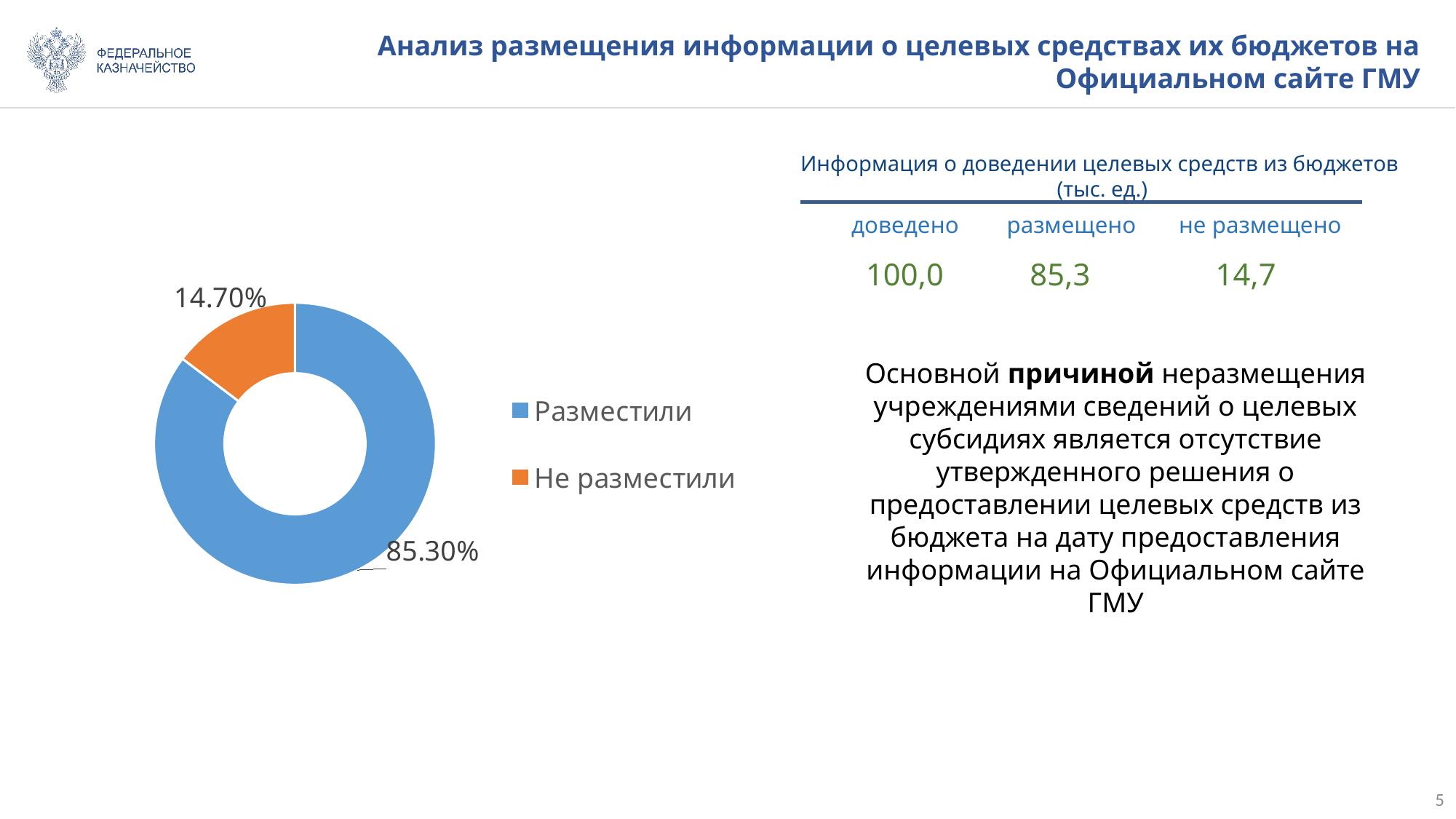
What is the share of the "Не разместили" slice in the doughnut chart? 14.70% Which slice of the doughnut chart is the smallest? Не разместили What share of the doughnut chart is labelled "Не разместили"? 14.70% What kind of chart is shown on the slide? Doughnut (pie) chart How many slices does the doughnut chart have? 2 Which slice of the doughnut chart is the largest? Разместили How many entries does the chart legend list? 2 By how many percentage points does the "Разместили" slice exceed the "Не разместили" slice? 70.60% Which is larger in the doughnut chart: "Разместили" or "Не разместили"? Разместили What colour is the "Разместили" slice in the doughnut chart? Blue What colour is the "Не разместили" slice in the doughnut chart? Orange What share of the doughnut chart is labelled "Разместили"? 85.30%